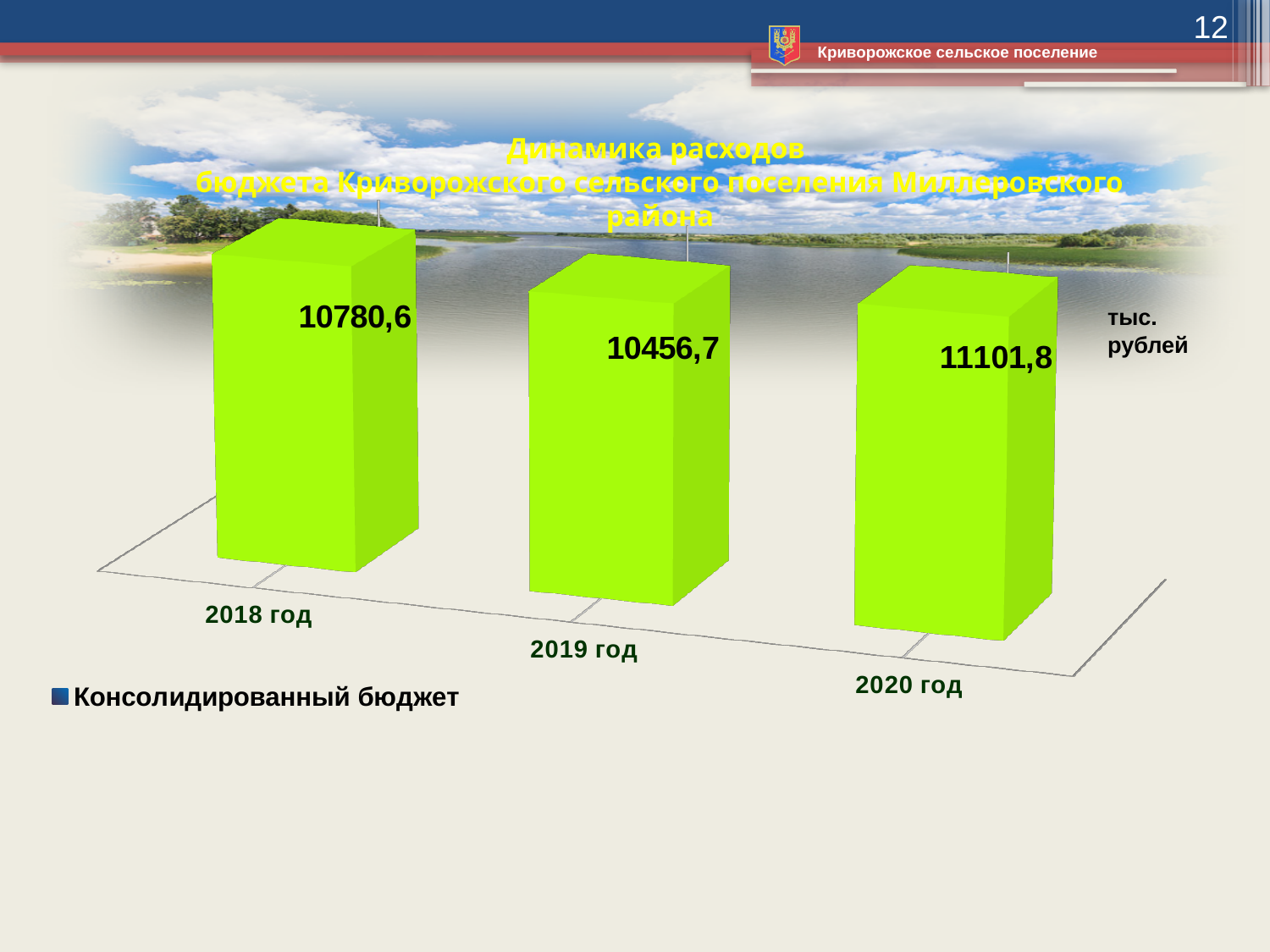
What is the value for 2018 год? 10780,6 What series name is shown in the legend? Консолидированный бюджет What is the value for 2019 год? 10456,7 Which year has the lowest value according to the data labels? 2019 год What is the value for 2020 год? 11101,8 What is the difference between the values for 2020 год and 2019 год? 645,1 What is the difference between the values for 2018 год and 2019 год? 323,9 How many years (categories) are shown in the chart? 3 How many series does the legend list? 1 Which is larger, the value for 2018 год or the value for 2019 год? 2018 год What kind of chart is shown on the slide? Bar chart Which year has the highest value according to the data labels? 2020 год